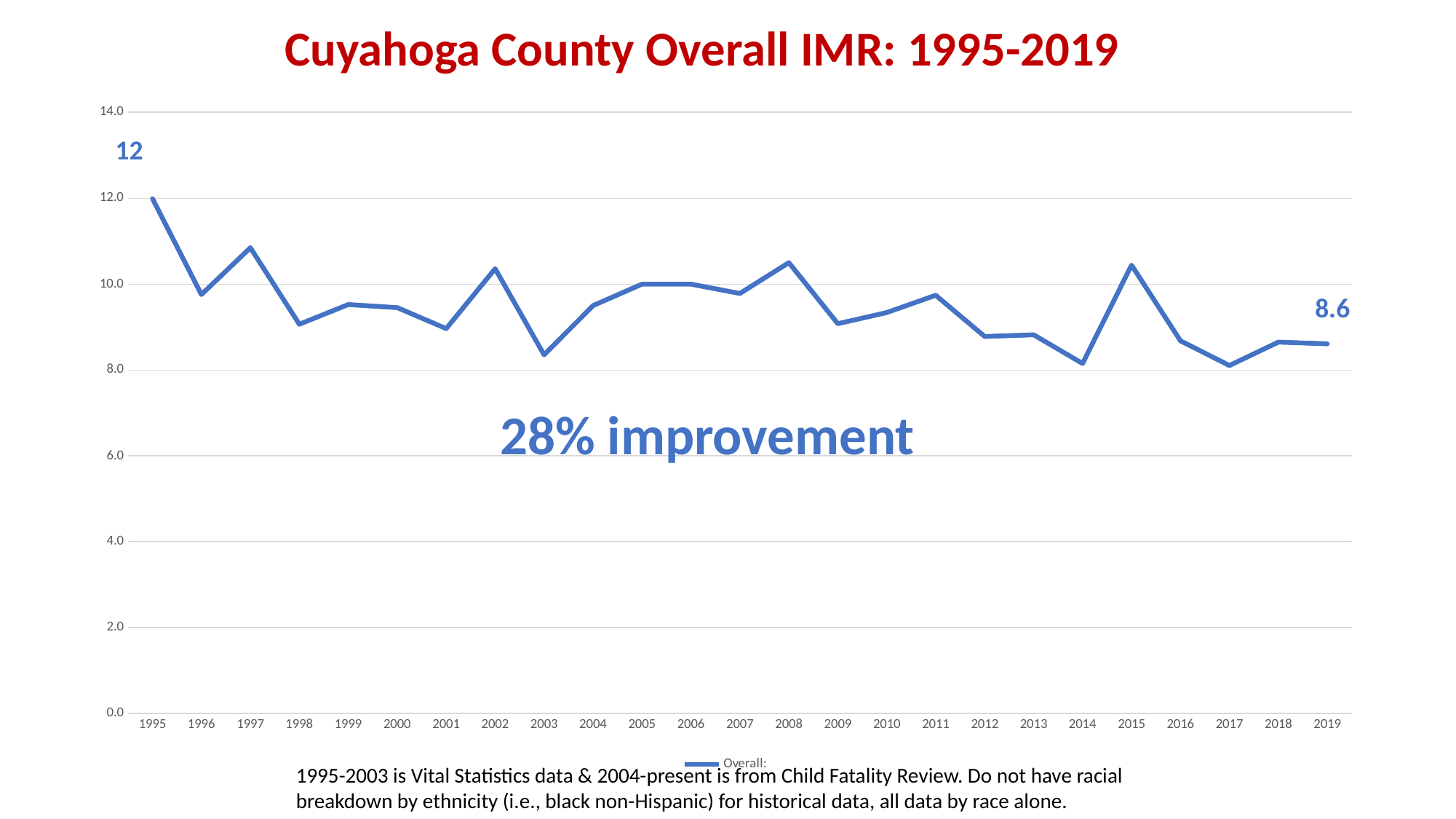
What is the value for 1995? 12 What is the difference between the 1995 value and the 2019 value? 3.4 How many years are plotted on the x axis? 25 What is the value for 2019? 8.6 What kind of chart is shown? line chart Which year has the highest value? 1995 Is the value for 2015 greater or less than 10.0? greater Is the value for 2003 greater or less than 10.0? less Which is larger, the value for 2002 or the value for 2003? 2002 How many series does the legend list? 1 Which is larger, the value for 1995 or the value for 2019? 1995 Do the values generally rise or fall from 1995 to 2019? fall